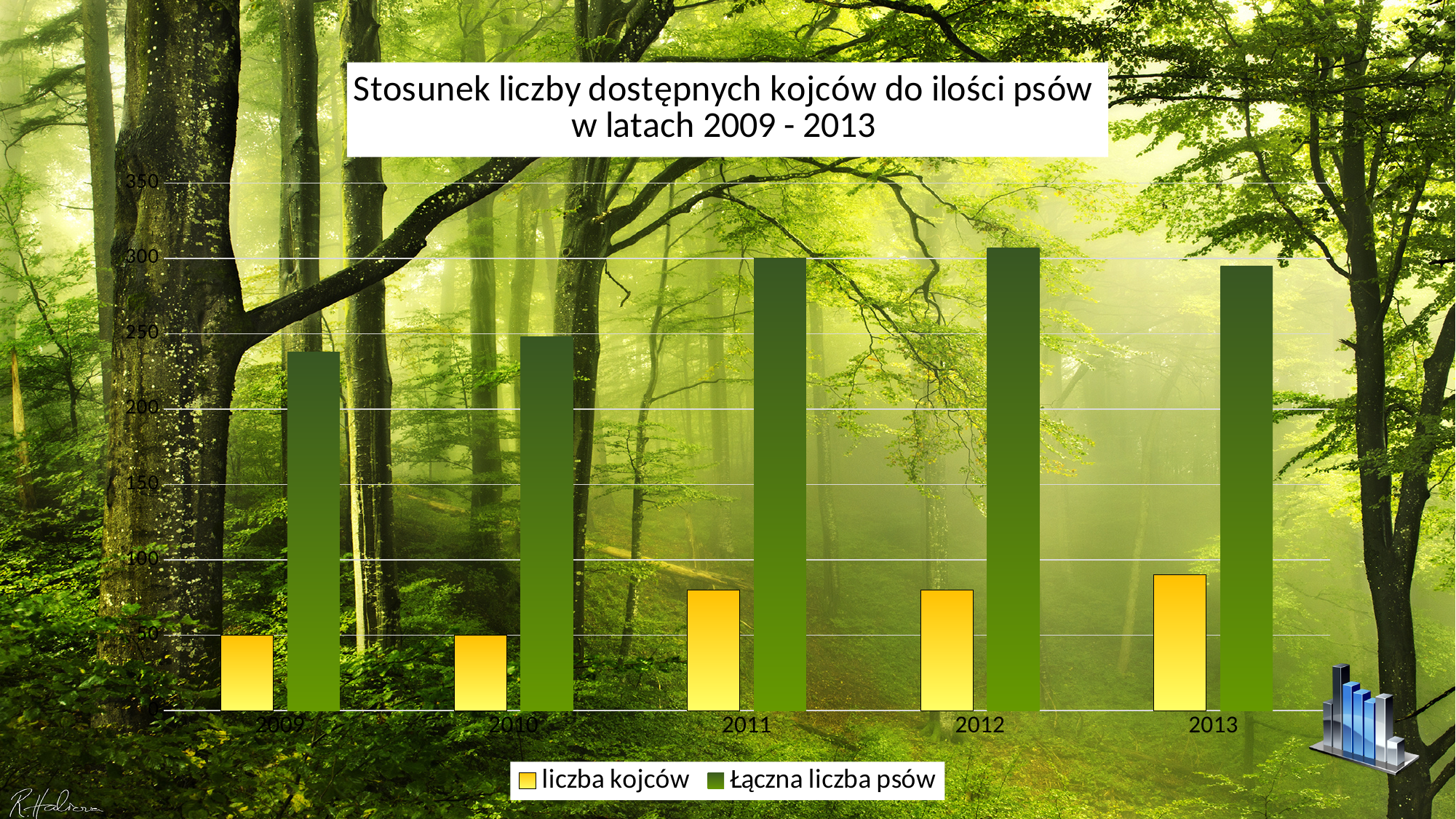
In which year is the value for liczba kojców highest? 2013 Is the value for Łączna liczba psów in 2010 greater or less than 200? greater What is the title of the chart? Stosunek liczby dostępnych kojców do ilości psów w latach 2009 - 2013 Is the value for Łączna liczba psów in 2009 greater or less than 250? less Is the value for liczba kojców in 2011 greater or less than 100? less Do the values for liczba kojców generally rise or fall from 2009 to 2013? rise Which is larger, the value for Łączna liczba psów in 2009 or in 2011? 2011 How many years are shown on the x axis? 5 Which series is shown in yellow? liczba kojców What kind of chart is shown on the slide? bar chart How many series does the legend list? 2